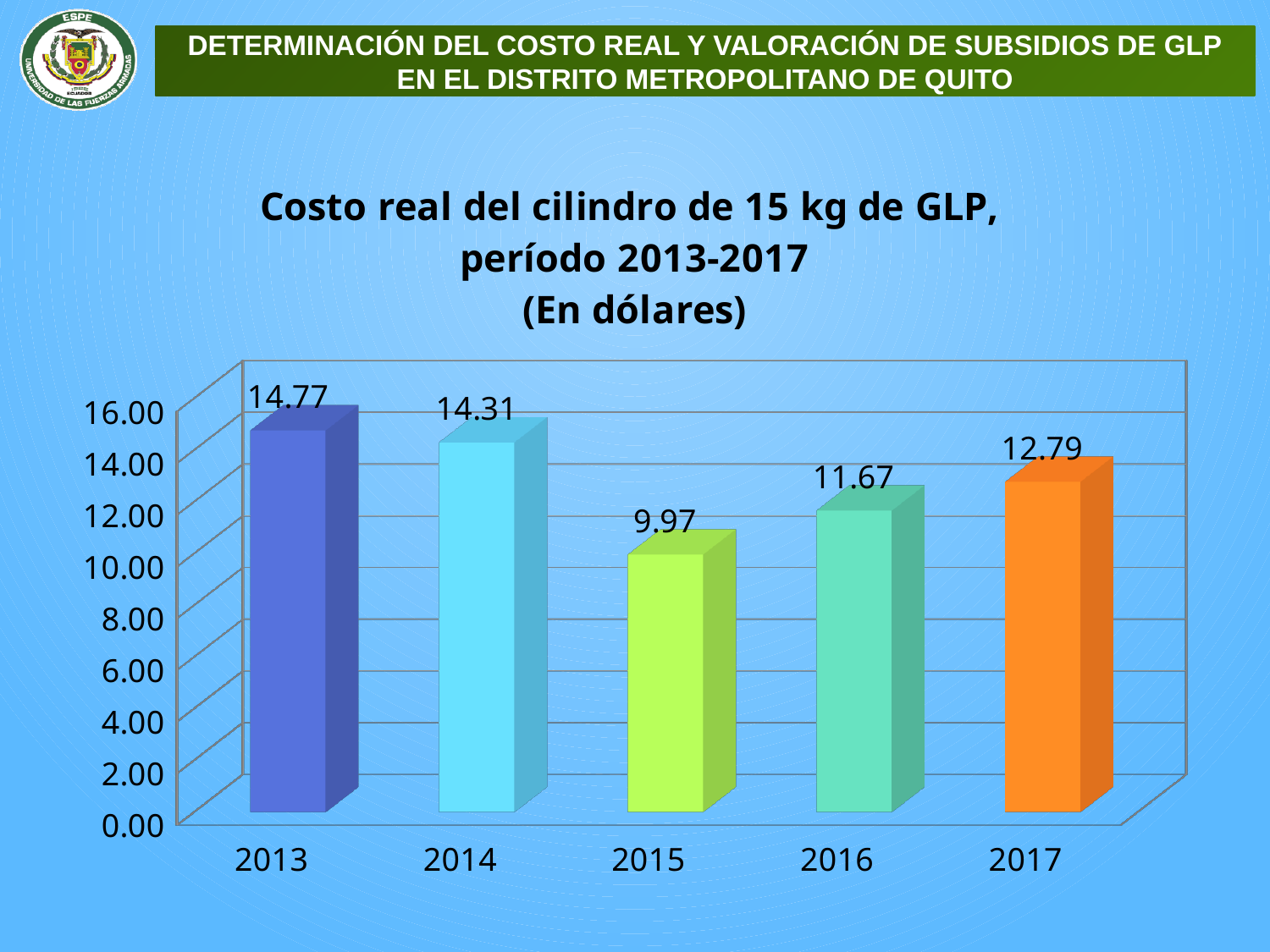
What is the real cost of the 15 kg GLP cylinder in 2017? 12.79 What is the difference between the real cost in 2013 and in 2014? 0.46 Does the real cost rise or fall from 2013 to 2015? Fall Which year has the lowest real cost of the 15 kg GLP cylinder? 2015 Which year has the highest real cost of the 15 kg GLP cylinder? 2013 Which year has a higher real cost, 2016 or 2017? 2017 What kind of chart is shown on the slide? Bar chart What is the real cost of the 15 kg GLP cylinder in 2013? 14.77 What is the difference between the real cost in 2017 and in 2016? 1.12 Is the value for 2016 greater or less than 12.00? less How many years are shown on the chart? 5 What is the real cost of the 15 kg GLP cylinder in 2015? 9.97